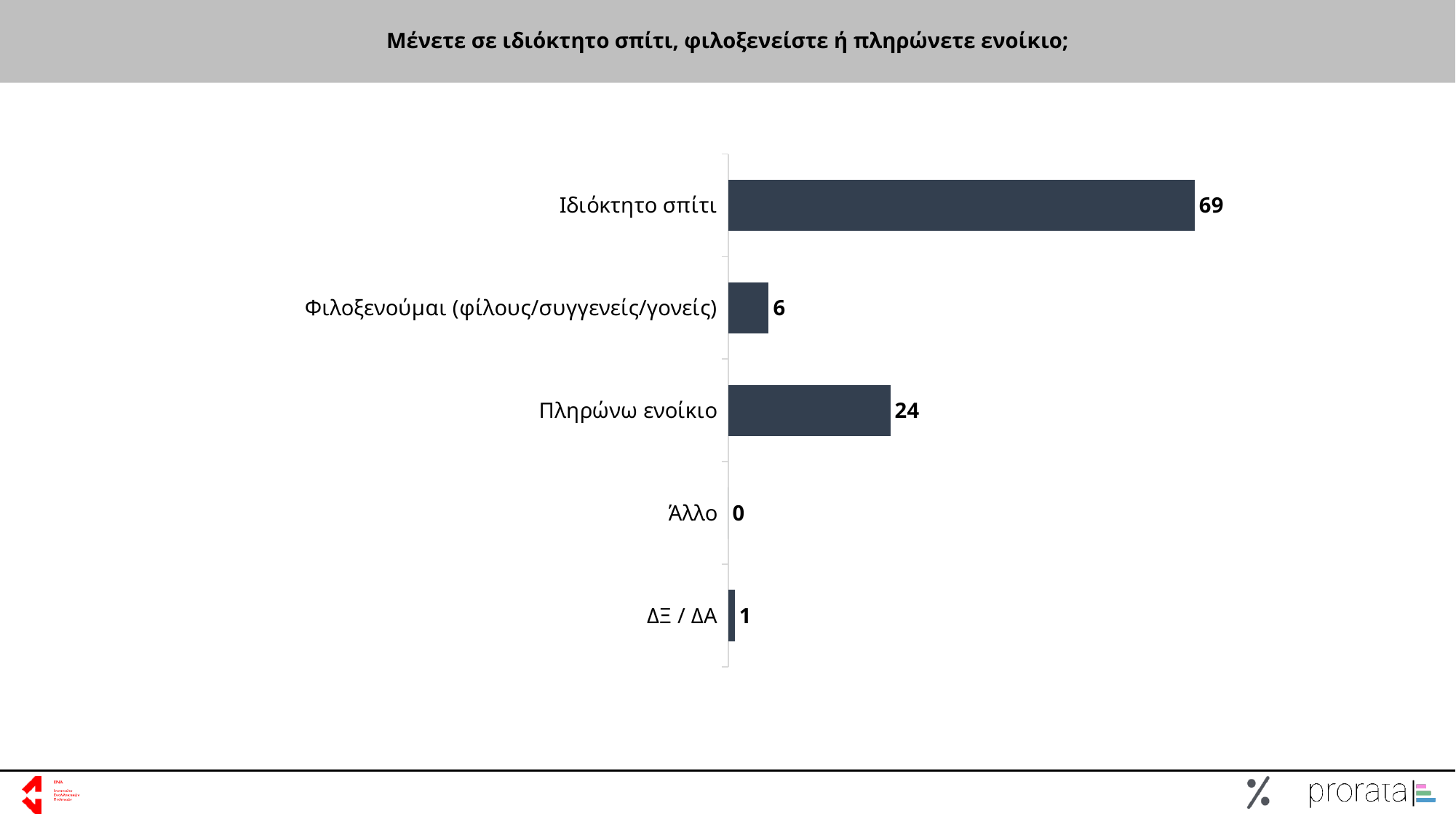
What is the value for Φιλοξενούμαι (φίλους/συγγενείς/γονείς)? 6 What is the value for Ιδιόκτητο σπίτι? 69 Which category has the highest value? Ιδιόκτητο σπίτι Which category has the lowest value? Άλλο What is the value for ΔΞ / ΔΑ? 1 Which is larger, the value for Πληρώνω ενοίκιο or the value for Φιλοξενούμαι (φίλους/συγγενείς/γονείς)? Πληρώνω ενοίκιο What kind of chart is shown on the slide? Bar chart What is the difference between the values for Ιδιόκτητο σπίτι and Πληρώνω ενοίκιο? 45 What is the value for Πληρώνω ενοίκιο? 24 How many categories are shown in the chart? 5 What is the value for Άλλο? 0 What is the title of the chart? Μένετε σε ιδιόκτητο σπίτι, φιλοξενείστε ή πληρώνετε ενοίκιο;